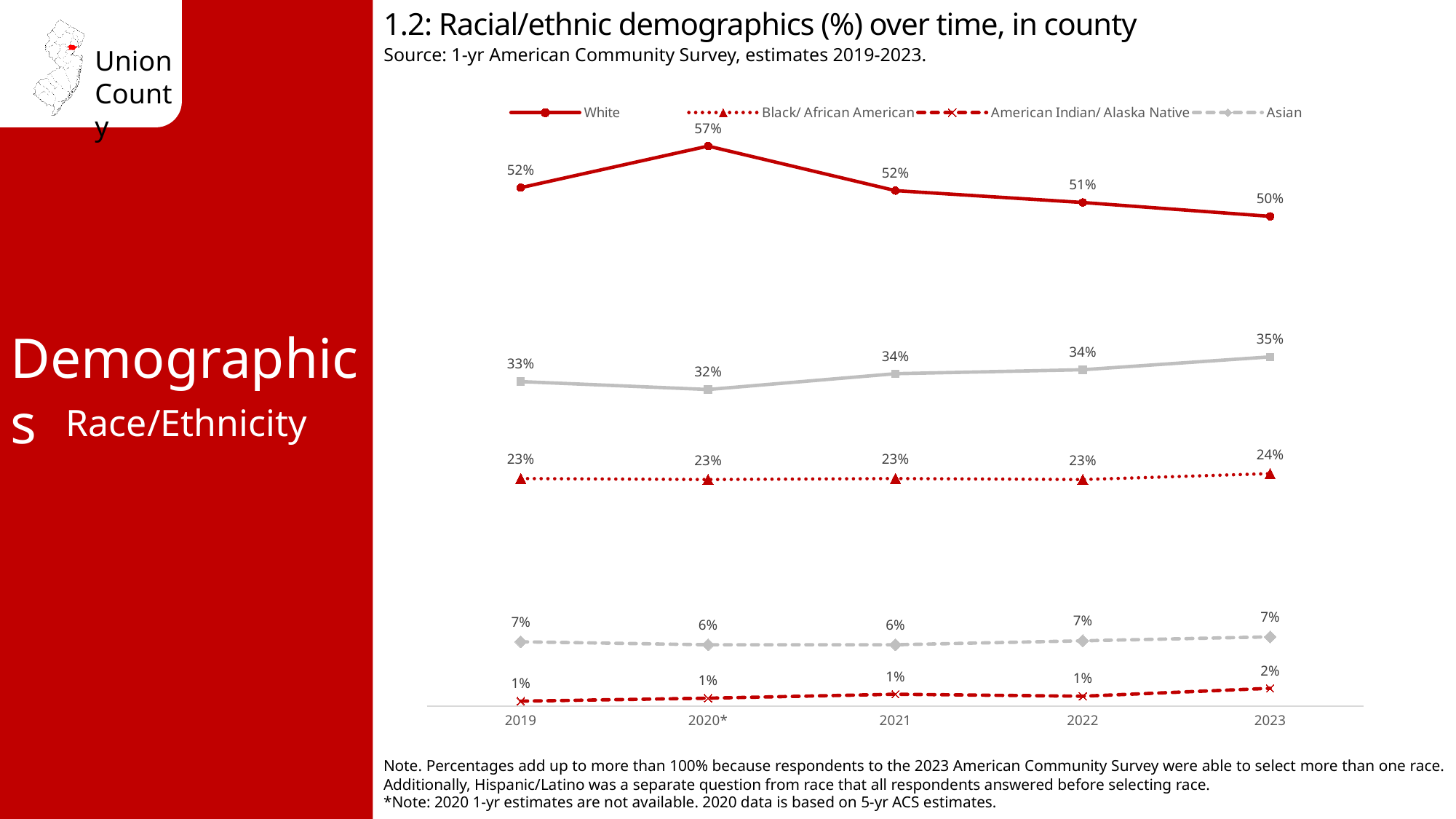
How many series does the legend list? 4 Does the White series rise or fall from 2020* to 2023? fall In which year is the White series at its highest? 2020* How many years are shown on the x axis? 5 What type of chart is shown on the slide? line chart Which is larger in 2019: the value for White or the value for Black/ African American? White What is the value for Black/ African American in 2023? 24% What is the value for White in 2020*? 57% What is the difference between the White value in 2020* and the White value in 2023? 7% In which year is the White series at its lowest? 2023 What is the value for American Indian/ Alaska Native in 2023? 2% What is the value for Asian in 2021? 6%